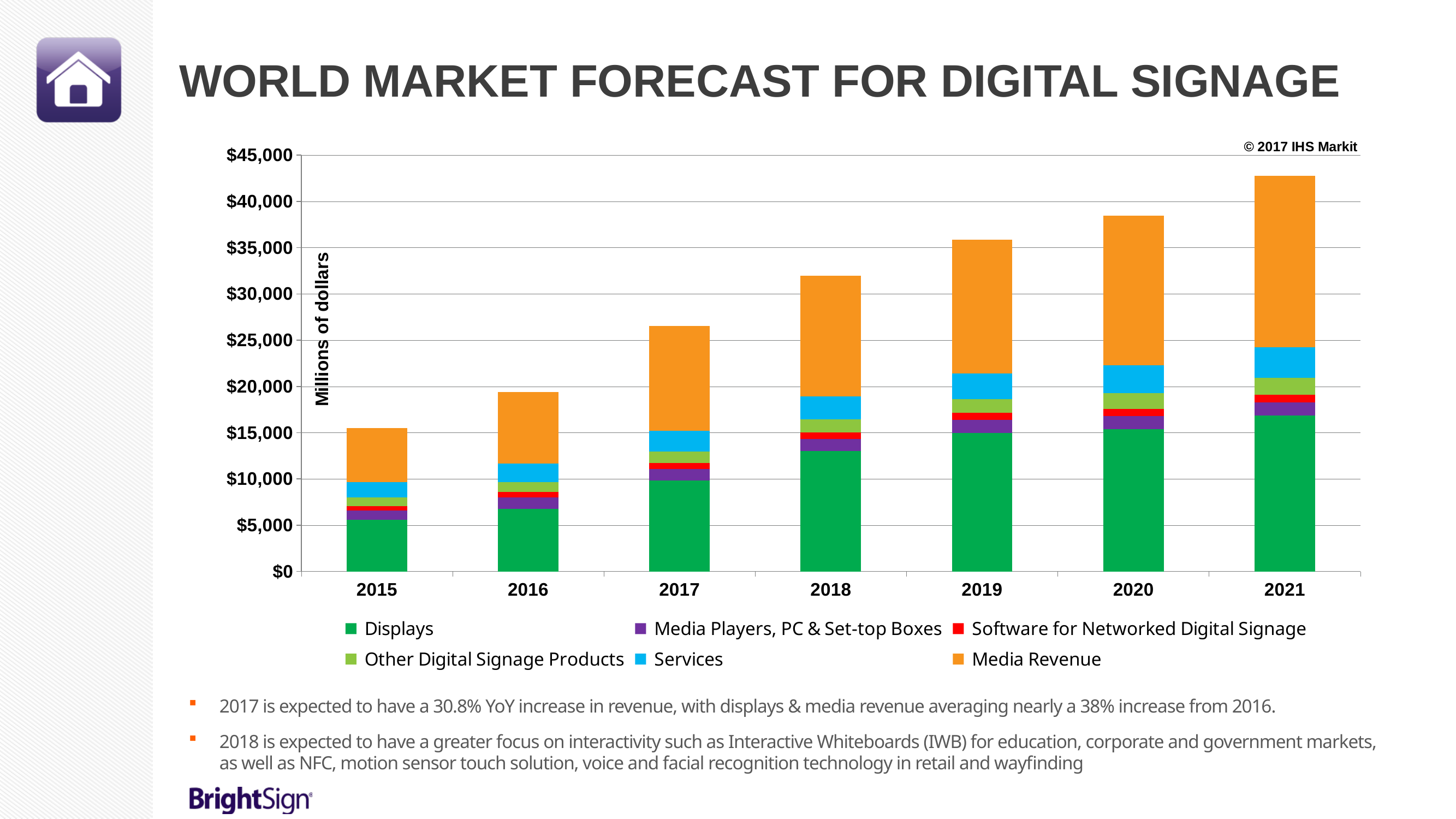
Which is larger, the total bar for 2017 or the total bar for 2020? 2020 Do the total bar heights rise or fall from 2015 to 2021? Rise How many series does the chart's legend list? 6 What kind of chart is shown on the slide? Stacked bar chart Is the Displays segment for 2021 greater or less than $15,000? greater What is the label on the chart's vertical axis? Millions of dollars How many years are shown along the x axis of the chart? 7 Is the total bar for 2015 greater or less than $20,000? less Is the total bar for 2021 greater or less than $40,000? greater Which year has the highest total bar? 2021 Which year has the lowest total bar? 2015